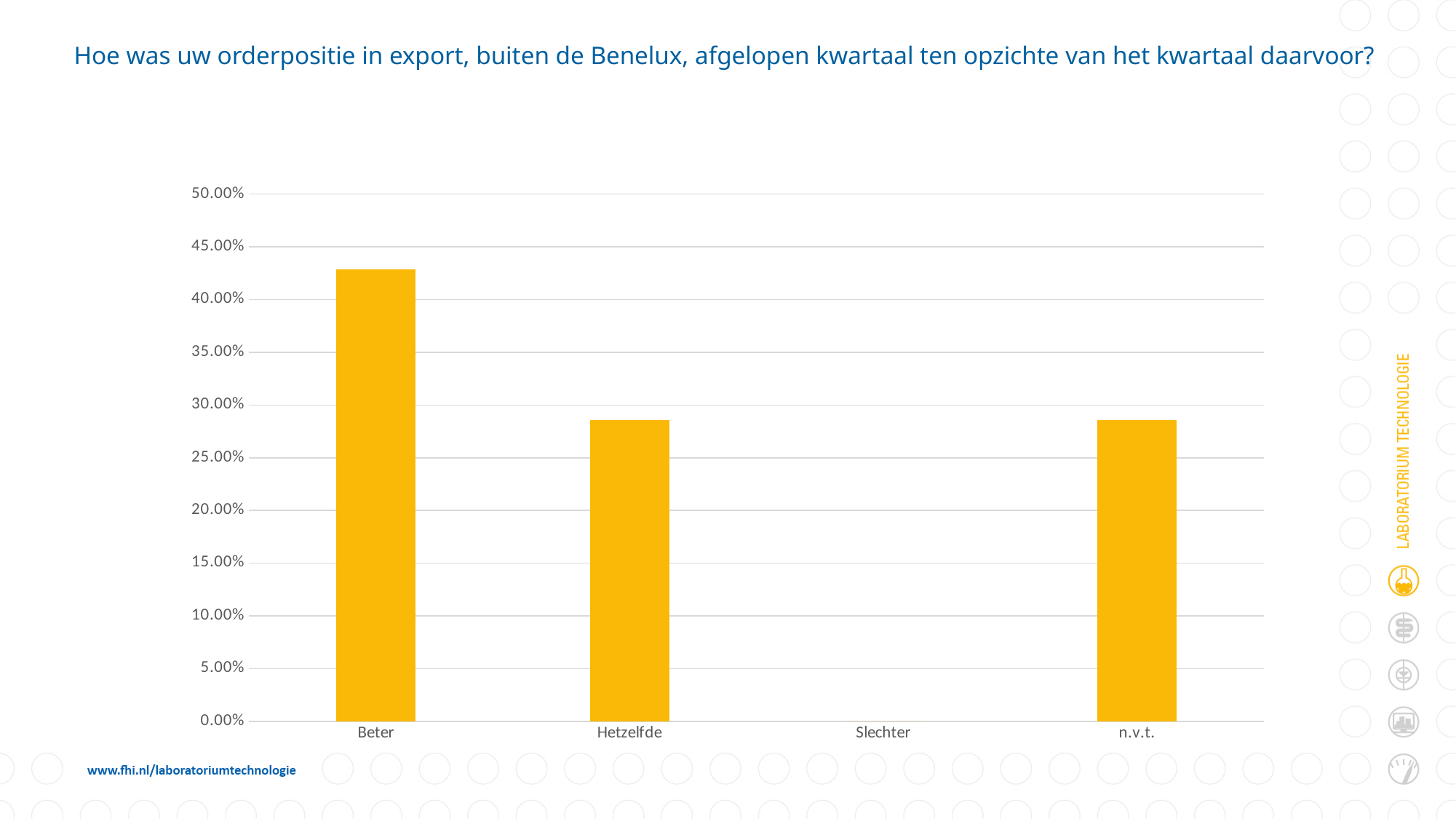
How many categories are shown on the x axis of the chart? 4 What is the value for Slechter? 0.00% Which is larger, the value for n.v.t. or the value for Slechter? n.v.t. What colour are the bars in the chart? yellow Which category has the highest value in the chart? Beter Is the value for n.v.t. greater or less than 25.00%? greater What kind of chart is shown on the slide? bar chart Is the value for Hetzelfde greater or less than 30.00%? less Which is larger, the value for Beter or the value for Hetzelfde? Beter Is the value for Beter greater or less than 45.00%? less Which category has the lowest value in the chart? Slechter